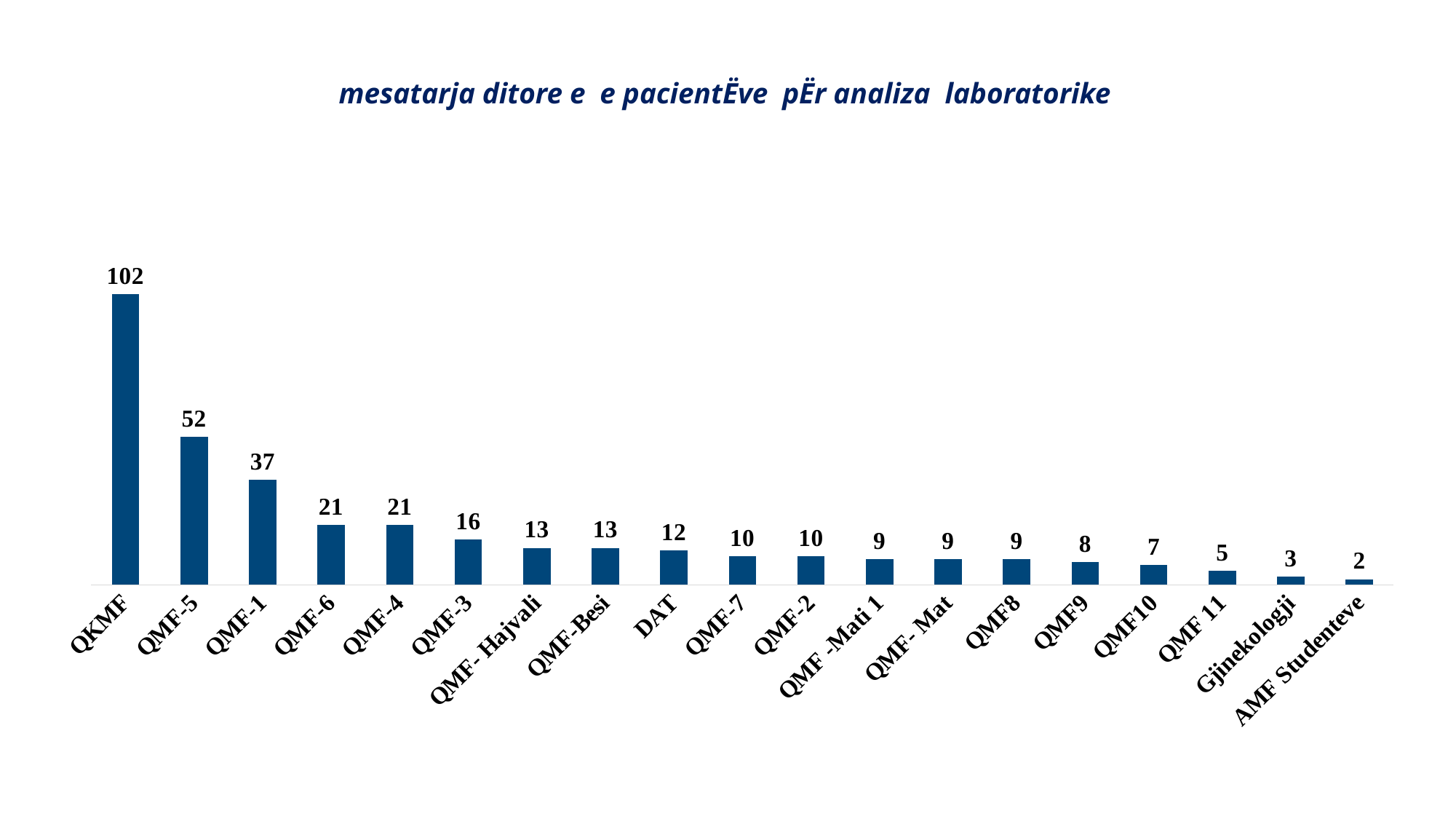
What is the value for QKMF? 102 How many categories are shown on the chart? 19 What is the difference between the values for QKMF and QMF-5? 50 What is the value for Gjinekologji? 3 What is the value for DAT? 12 Which category has the lowest value? AMF Studenteve Which is larger, the value for QMF-6 or the value for QMF-Besi? QMF-6 What kind of chart is this? Bar chart Which category has the highest value? QKMF What is the value for QMF-1? 37 What is the difference between the values for QMF-3 and QMF10? 9 Do the values rise or fall from left to right along the x axis? Fall